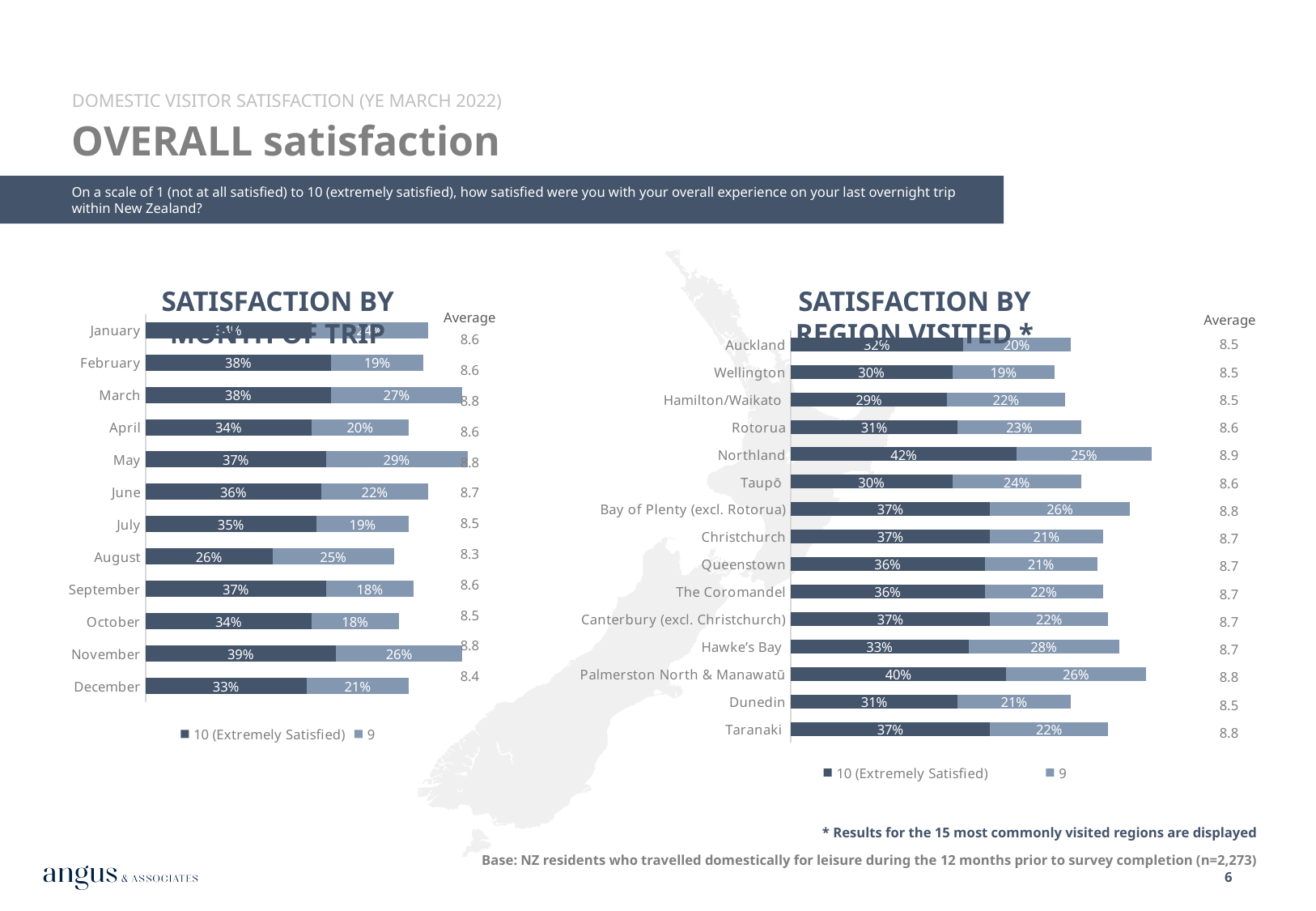
In the Satisfaction by Region Visited chart, what percentage of visitors to Hawke's Bay gave a rating of 9? 28% In the Satisfaction by Month of Trip chart, how many months are plotted? 12 In the Satisfaction by Month of Trip chart, what is the combined percentage of 10 and 9 ratings for March? 65% What type of chart is the Satisfaction by Region Visited chart? Stacked bar chart In the Satisfaction by Region Visited chart, how many series does the legend list? 2 In the Satisfaction by Region Visited chart, what is the difference between the 10 (Extremely Satisfied) percentages for Palmerston North & Manawatū and Dunedin? 9% In the Satisfaction by Month of Trip chart, which month has the lowest percentage of 10 (Extremely Satisfied) ratings? August In the Satisfaction by Month of Trip chart, what percentage of visitors in November gave a rating of 10 (Extremely Satisfied)? 39% In the Satisfaction by Region Visited chart, which region has the highest percentage of 10 (Extremely Satisfied) ratings? Northland In the Satisfaction by Region Visited chart, which has a higher percentage of 10 (Extremely Satisfied) ratings: Wellington or Rotorua? Rotorua In the Satisfaction by Month of Trip chart, what percentage of visitors in May gave a rating of 9? 29% In the Satisfaction by Month of Trip chart, what is the average satisfaction score shown for August? 8.3